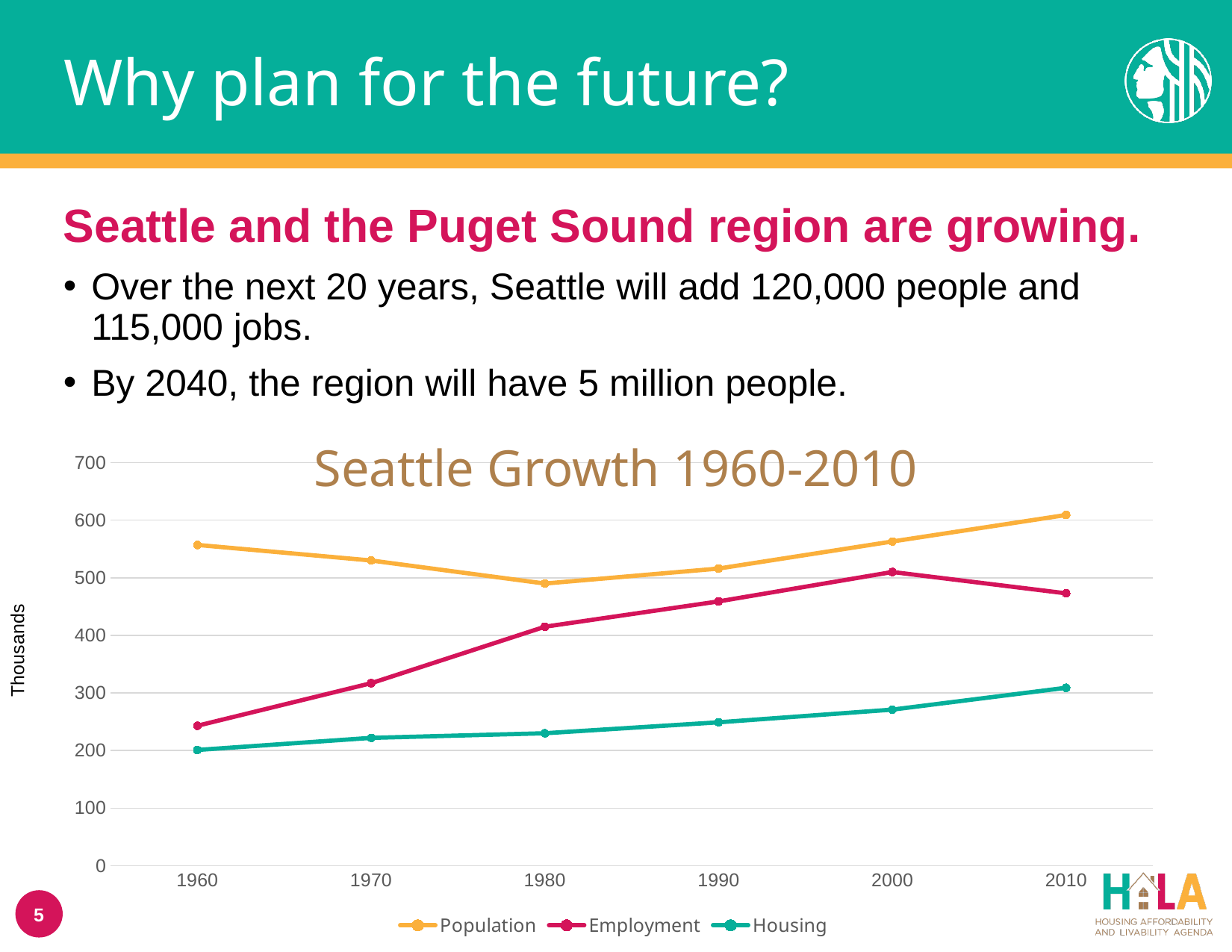
Is the Population value for 2010 greater or less than 600? greater In which year is the Employment series at its highest? 2000 Is the Employment value for 1960 greater or less than 300? less How many series does the chart legend list? 3 What is the title of the chart? Seattle Growth 1960-2010 In which year is the Population series at its highest? 2010 Is the Housing value for 1990 greater or less than 300? less How many years are plotted along the x axis of the chart? 6 What kind of chart is shown on the slide? line chart What is the label on the vertical axis of the chart? Thousands Does the Housing series rise or fall from 1960 to 2010? rise